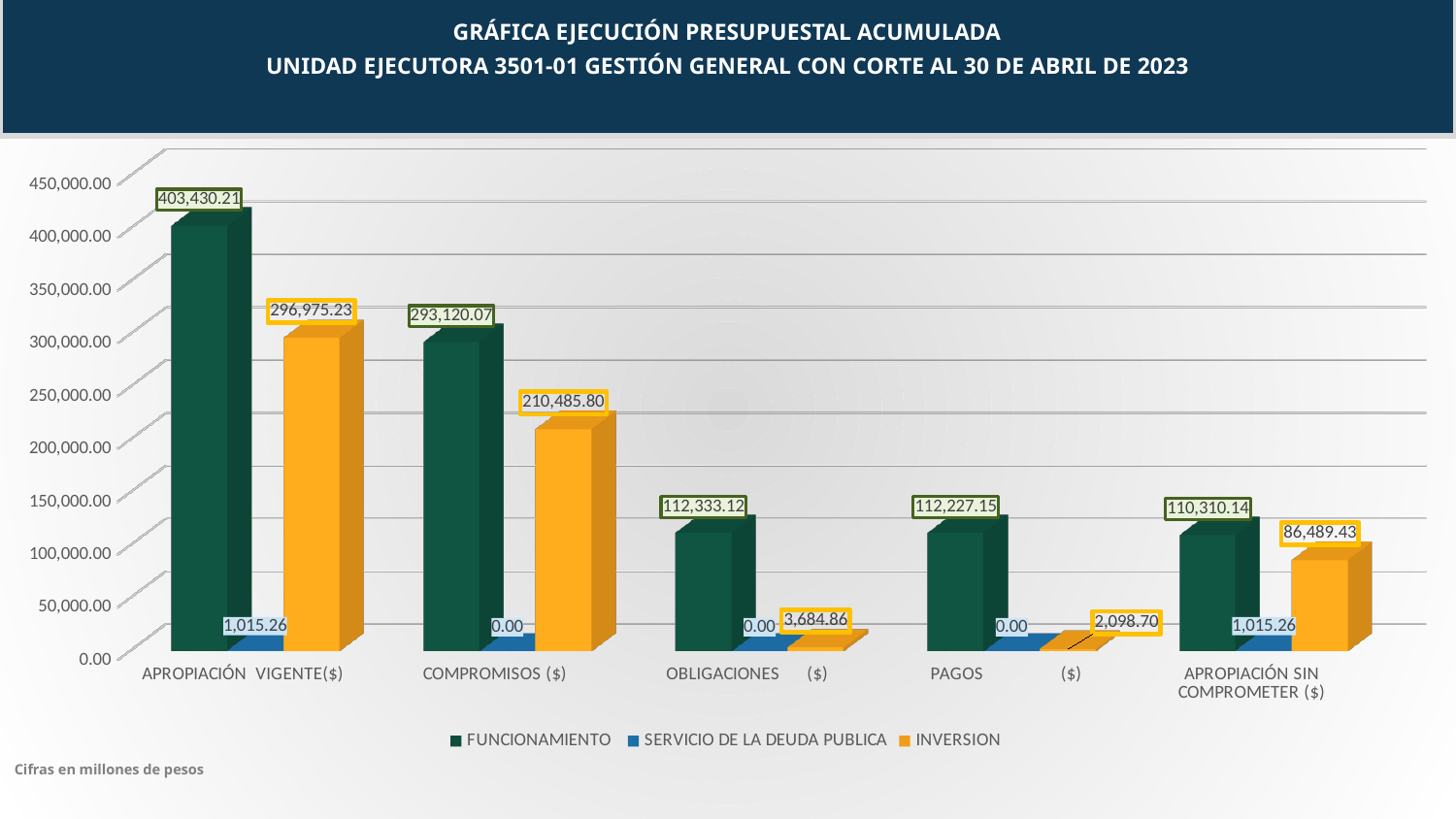
Which category has the highest FUNCIONAMIENTO value? APROPIACIÓN VIGENTE($) What is the difference between the FUNCIONAMIENTO and INVERSION values for APROPIACIÓN VIGENTE($)? 106,454.98 What is the INVERSION value for COMPROMISOS ($)? 210,485.80 How many categories are shown on the x axis? 5 Which category has the lowest INVERSION value? PAGOS ($) Which is larger for COMPROMISOS ($): the FUNCIONAMIENTO value or the INVERSION value? FUNCIONAMIENTO Is the INVERSION value for COMPROMISOS ($) greater or less than 200,000.00? greater What is the INVERSION value for PAGOS ($)? 2,098.70 What is the SERVICIO DE LA DEUDA PUBLICA value for APROPIACIÓN SIN COMPROMETER ($)? 1,015.26 What kind of chart is shown on the slide? bar chart What is the FUNCIONAMIENTO value for APROPIACIÓN VIGENTE($)? 403,430.21 How many series does the legend list? 3